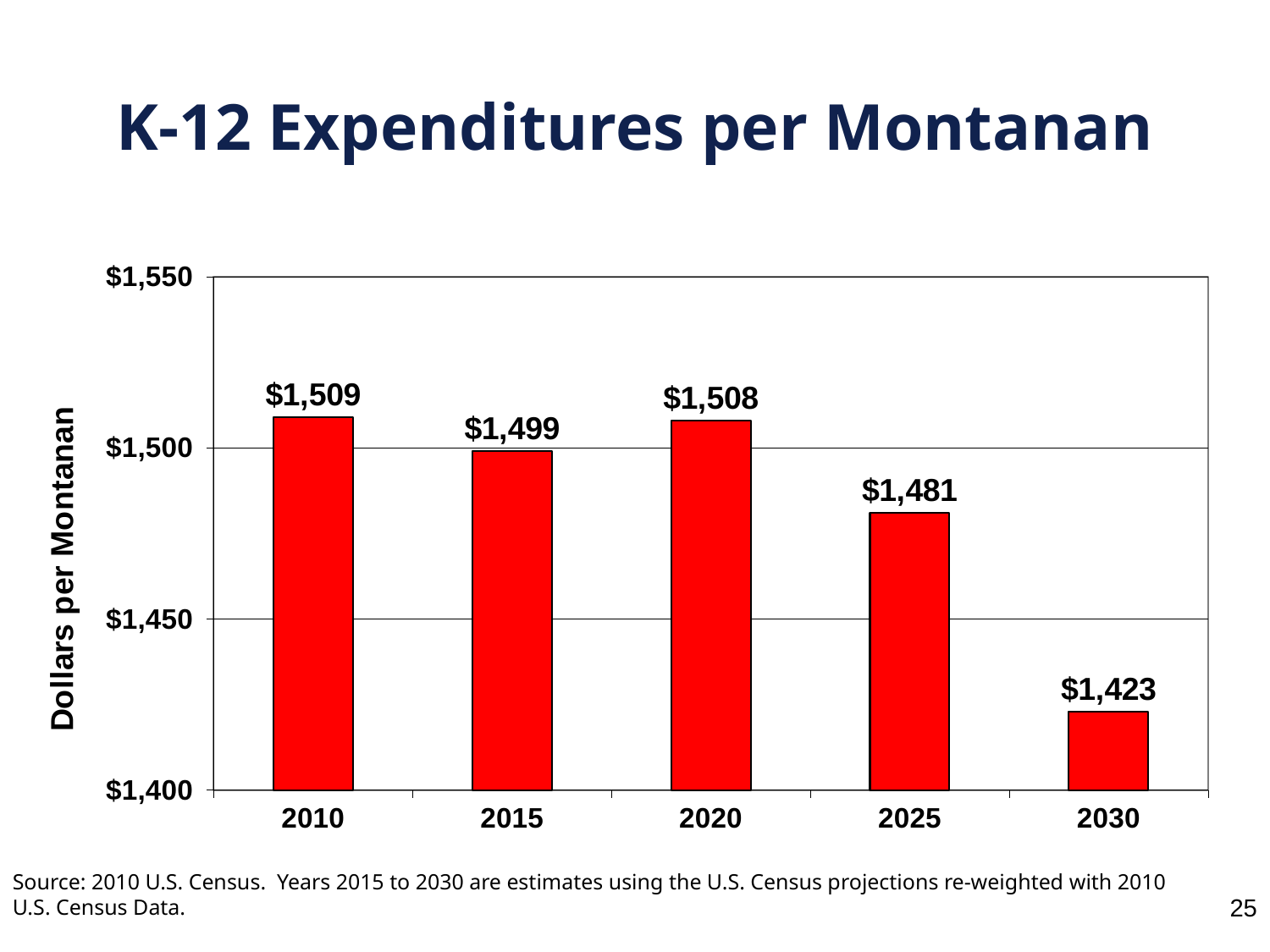
Is the value for 2030 greater or less than $1,450? less Which year has the highest value? 2010 What is the value for 2010? $1,509 What is the value for 2030? $1,423 What is the difference between the values for 2020 and 2025? $27 What is the difference between the values for 2010 and 2030? $86 Which year has the lowest value? 2030 Which is larger, the value for 2015 or the value for 2025? 2015 How many years are shown on the x axis? 5 What is the value for 2025? $1,481 What is the title of the chart? K-12 Expenditures per Montanan What kind of chart is this? bar chart